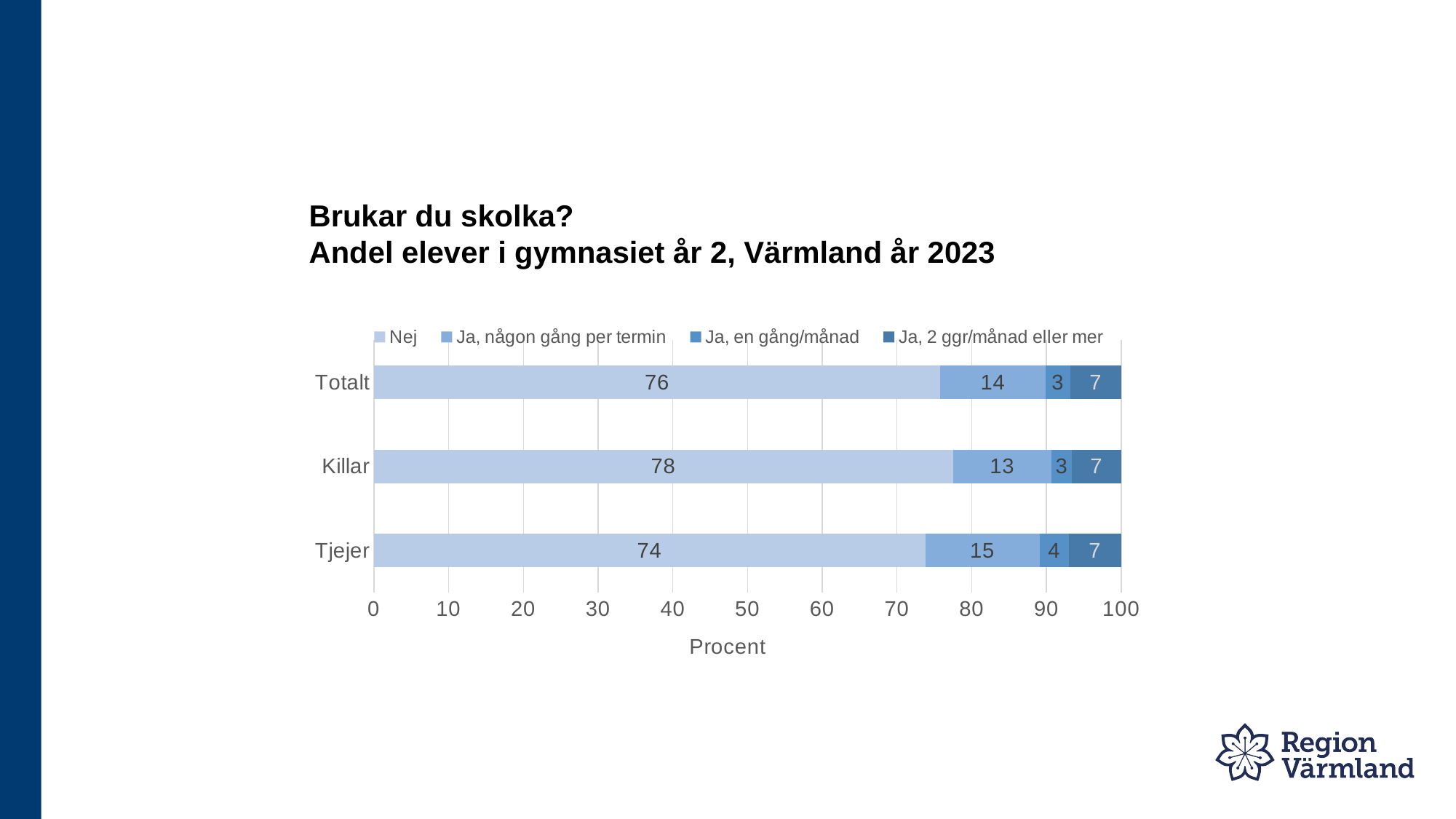
What kind of chart is shown on the slide? Stacked bar chart What is the value for "Ja, en gång/månad" for Killar? 3 How many series does the legend list? 4 Which category has the highest value for "Nej"? Killar What is the value for "Ja, 2 ggr/månad eller mer" for Tjejer? 7 What is the total of the stacked bar for Totalt? 100 Which is larger: the "Ja, någon gång per termin" value for Tjejer or for Killar? Tjejer What is the value for "Ja, någon gång per termin" for Tjejer? 15 What is the difference between the "Nej" values for Killar and Tjejer? 4 What is the value for "Nej" for Totalt? 76 How many categories are shown on the y axis? 3 Which category has the lowest value for "Nej"? Tjejer